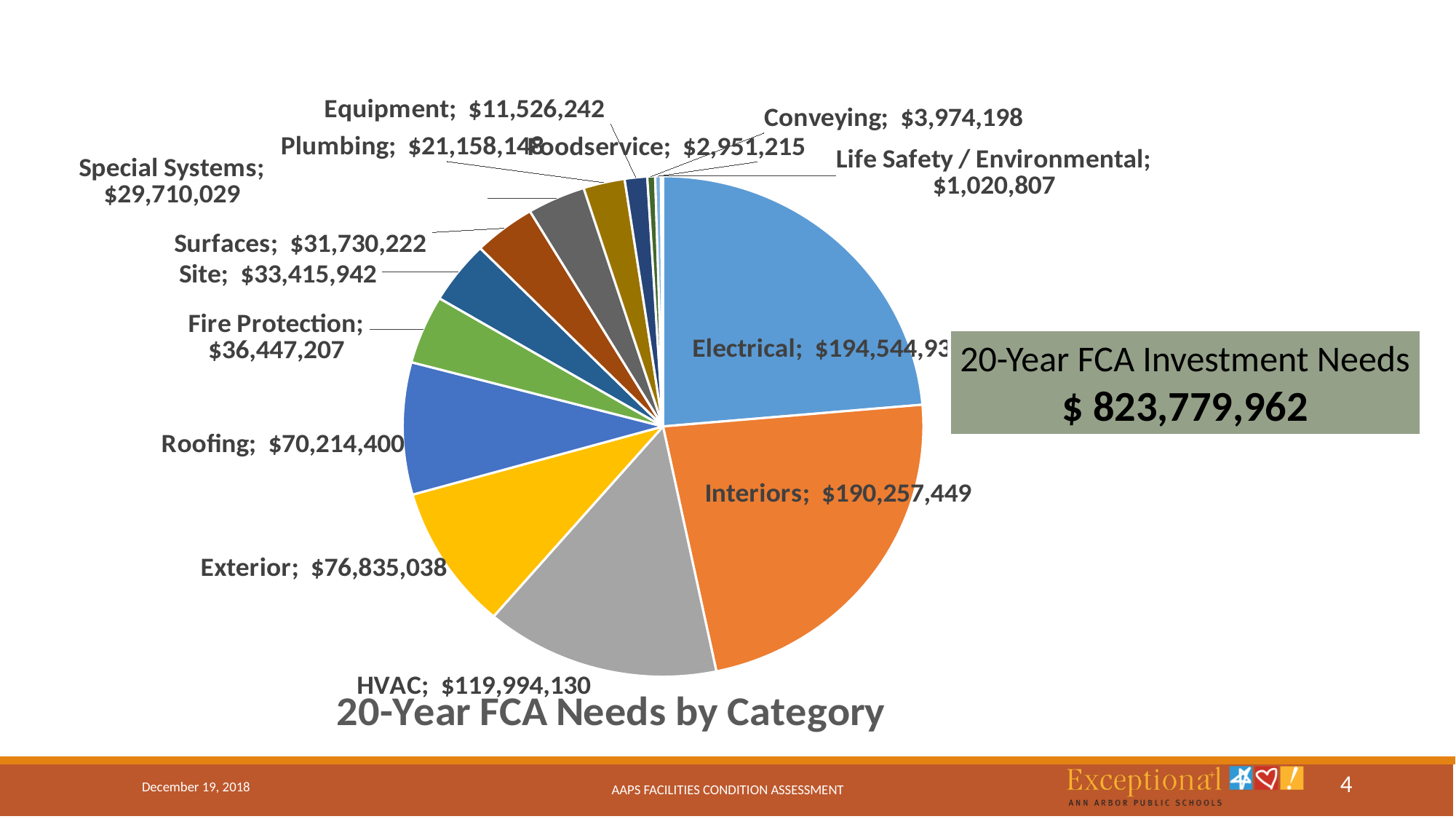
What type of chart is shown on the slide? Pie chart What total 20-Year FCA Investment Needs figure is shown on the slide? $ 823,779,962 What is the value for HVAC in the pie chart? $119,994,130 How many categories are shown in the pie chart? 14 What is the value for Roofing in the pie chart? $70,214,400 What is the value for Life Safety / Environmental in the pie chart? $1,020,807 What is the title of the pie chart? 20-Year FCA Needs by Category Which is larger, the value for Site or the value for Surfaces? Site What is the difference between the HVAC and Exterior values? $43,159,092 Which category has the largest slice in the pie chart? Electrical Which category has the smallest slice in the pie chart? Life Safety / Environmental What is the value for Interiors in the pie chart? $190,257,449